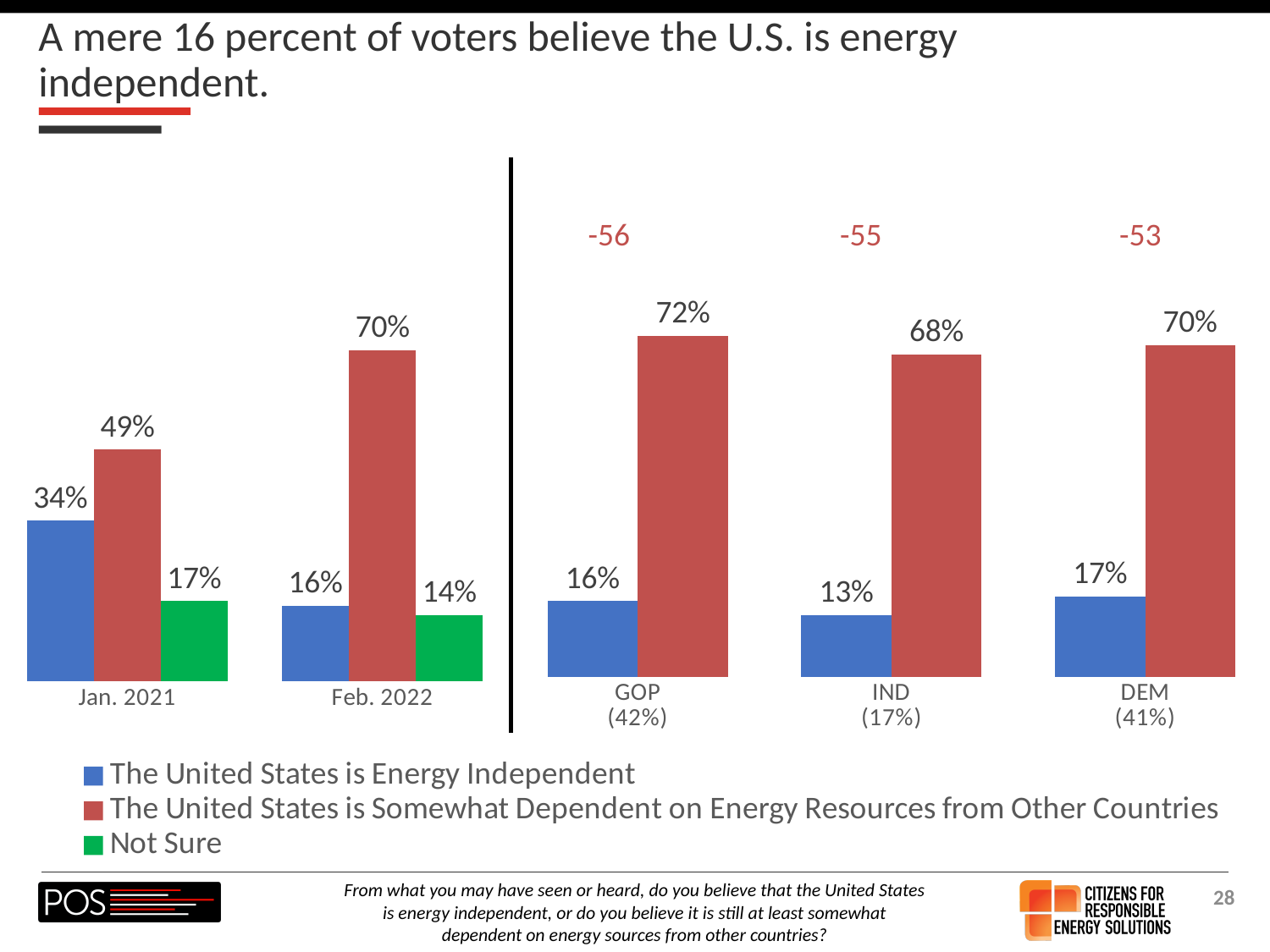
What is the difference between the Somewhat Dependent and Energy Independent values for DEM voters? 53 Among GOP, IND and DEM, which group has the highest share saying the United States is Somewhat Dependent on Energy Resources from Other Countries? GOP What percentage of voters in Jan. 2021 said the United States is Somewhat Dependent on Energy Resources from Other Countries? 49% What percentage of voters in Feb. 2022 said the United States is Energy Independent? 16% By how many percentage points did the share saying the United States is Energy Independent fall from Jan. 2021 to Feb. 2022? 18 Among GOP, IND and DEM, which group has the lowest share saying the United States is Energy Independent? IND What kind of chart is shown on the slide? Bar chart Which is larger: the Not Sure value for Jan. 2021 or the Not Sure value for Feb. 2022? Jan. 2021 What percentage of IND voters said the United States is Somewhat Dependent on Energy Resources from Other Countries? 68% What colour are the bars for the Not Sure series? Green How many series does the legend list? 3 What is the Not Sure value for Feb. 2022? 14%